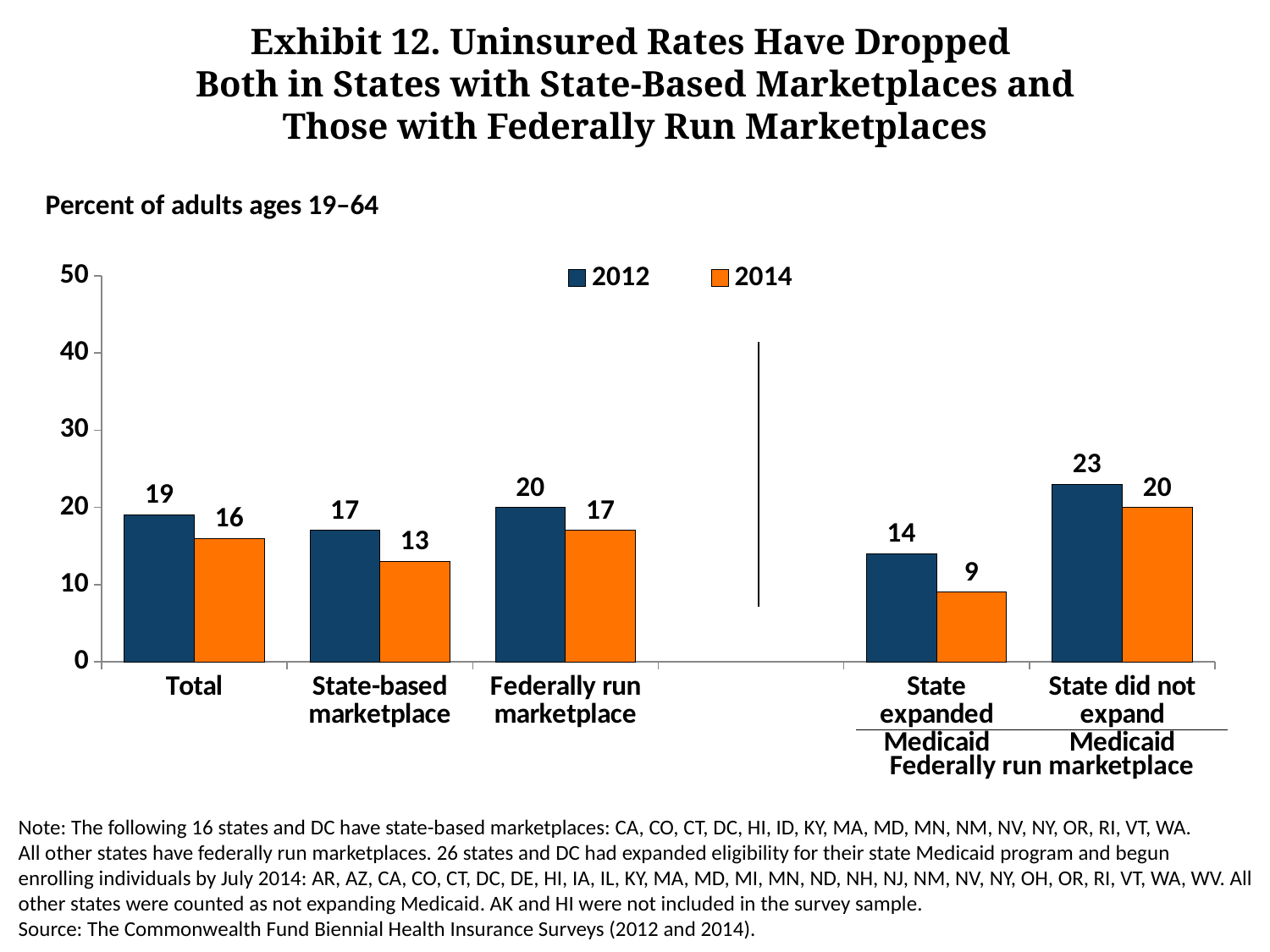
How many series does the legend list? 2 What was the uninsured rate for Total in 2012? 19 Which category has the highest 2012 value? State did not expand Medicaid Which category has the lowest 2014 value? State expanded Medicaid What was the 2014 value for states that expanded Medicaid (federally run marketplace)? 9 Which is larger: the 2014 value for Total or the 2014 value for State-based marketplace? Total What was the uninsured rate for State-based marketplace in 2014? 13 What is the difference between the 2012 values for State did not expand Medicaid and State expanded Medicaid? 9 What kind of chart is shown on the slide? Bar chart By how much did the uninsured rate for Federally run marketplace drop from 2012 to 2014? 3 How many categories are shown on the x axis? 5 Which years are listed in the legend? 2012 and 2014